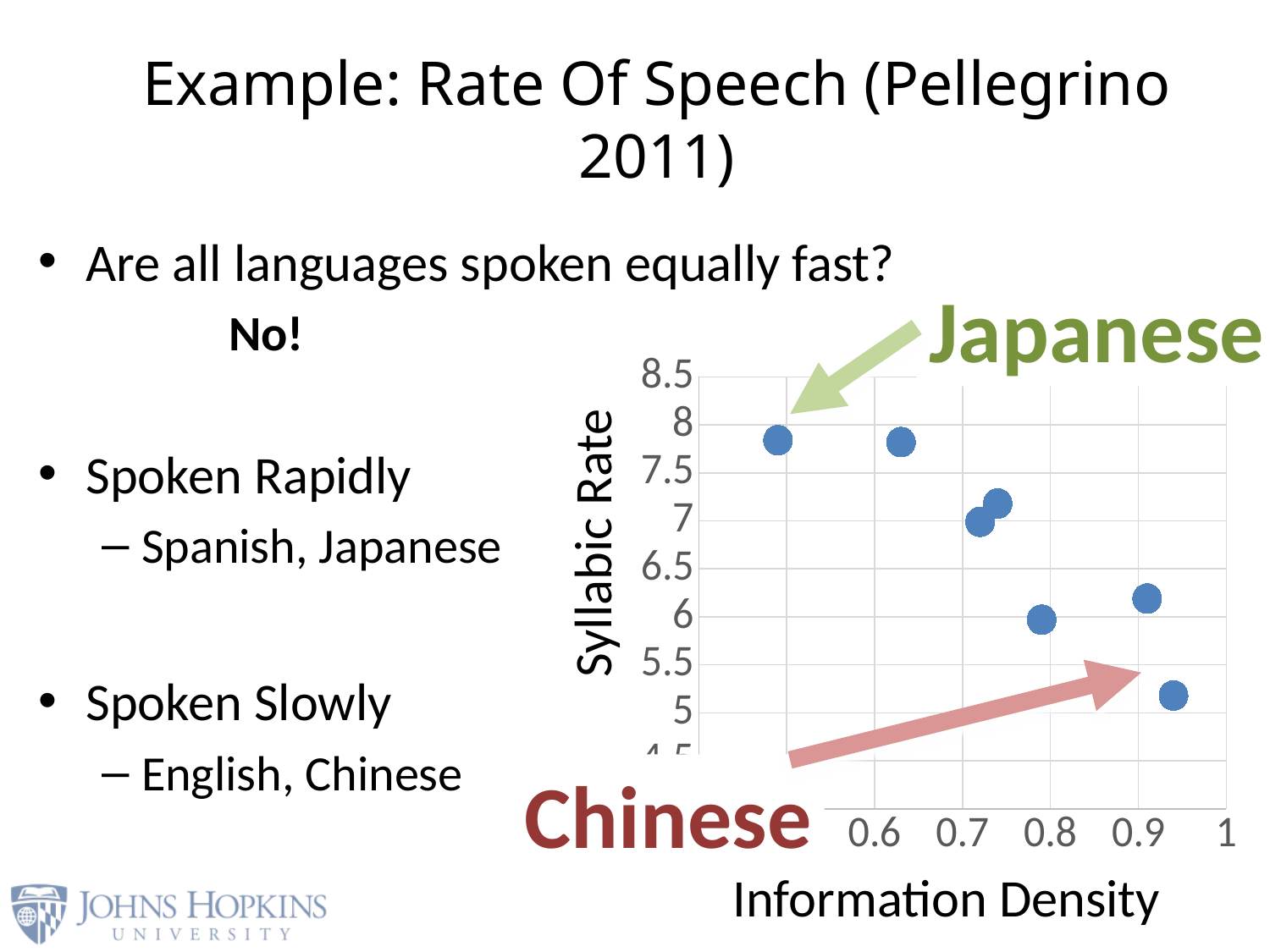
Is the syllabic rate of the point labelled Chinese greater or less than 5.5? less What kind of chart is shown on the slide? scatter chart Which labelled point has the lowest syllabic rate in the chart? Chinese Which has the higher syllabic rate, the point labelled Japanese or the point labelled Chinese? Japanese Is the information density of the point labelled Japanese greater or less than 0.6? less As information density increases along the x axis, does syllabic rate generally rise or fall? fall What is the label of the y axis of the chart? Syllabic Rate Is the syllabic rate of the point labelled Japanese greater or less than 7.5? greater Which labelled point has the lowest information density in the chart? Japanese How many data points are plotted in the chart? 7 What is the label of the x axis of the chart? Information Density